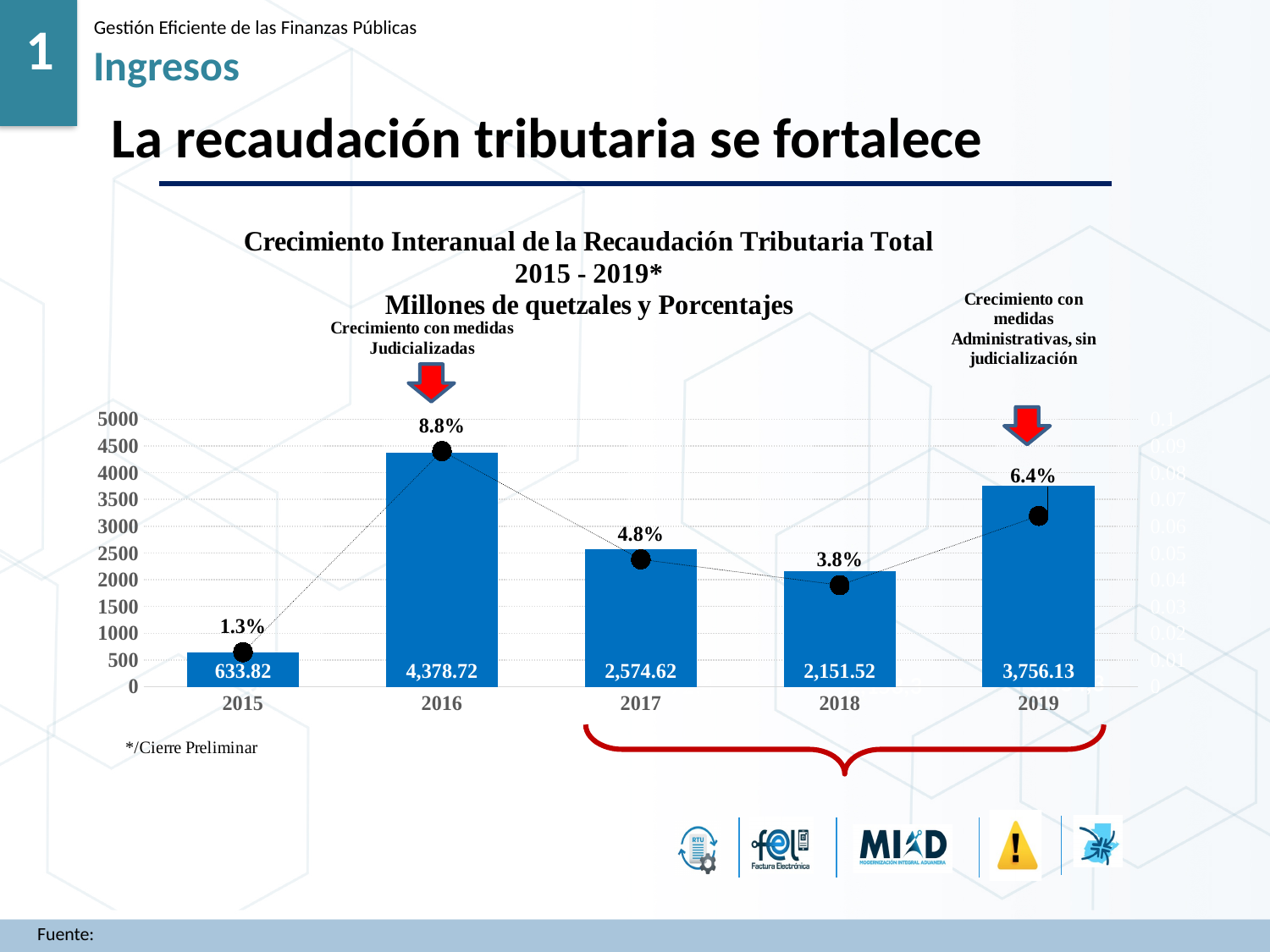
What is the title of the chart? Crecimiento Interanual de la Recaudación Tributaria Total 2015 - 2019* Millones de quetzales y Porcentajes Which year has the lowest bar value? 2015 What growth percentage is shown for 2017? 4.8% Which year has the highest bar value? 2016 How many years are shown on the x axis? 5 What growth percentage is shown for 2015? 1.3% What is the difference between the bar values for 2017 and 2018? 423.10 Is the bar value for 2018 greater or less than 2500? less What kind of chart is this? Bar chart with a line overlay What is the value of the bar for 2019? 3,756.13 Which is larger, the bar value for 2019 or for 2017? 2019 What is the value of the bar for 2016? 4,378.72